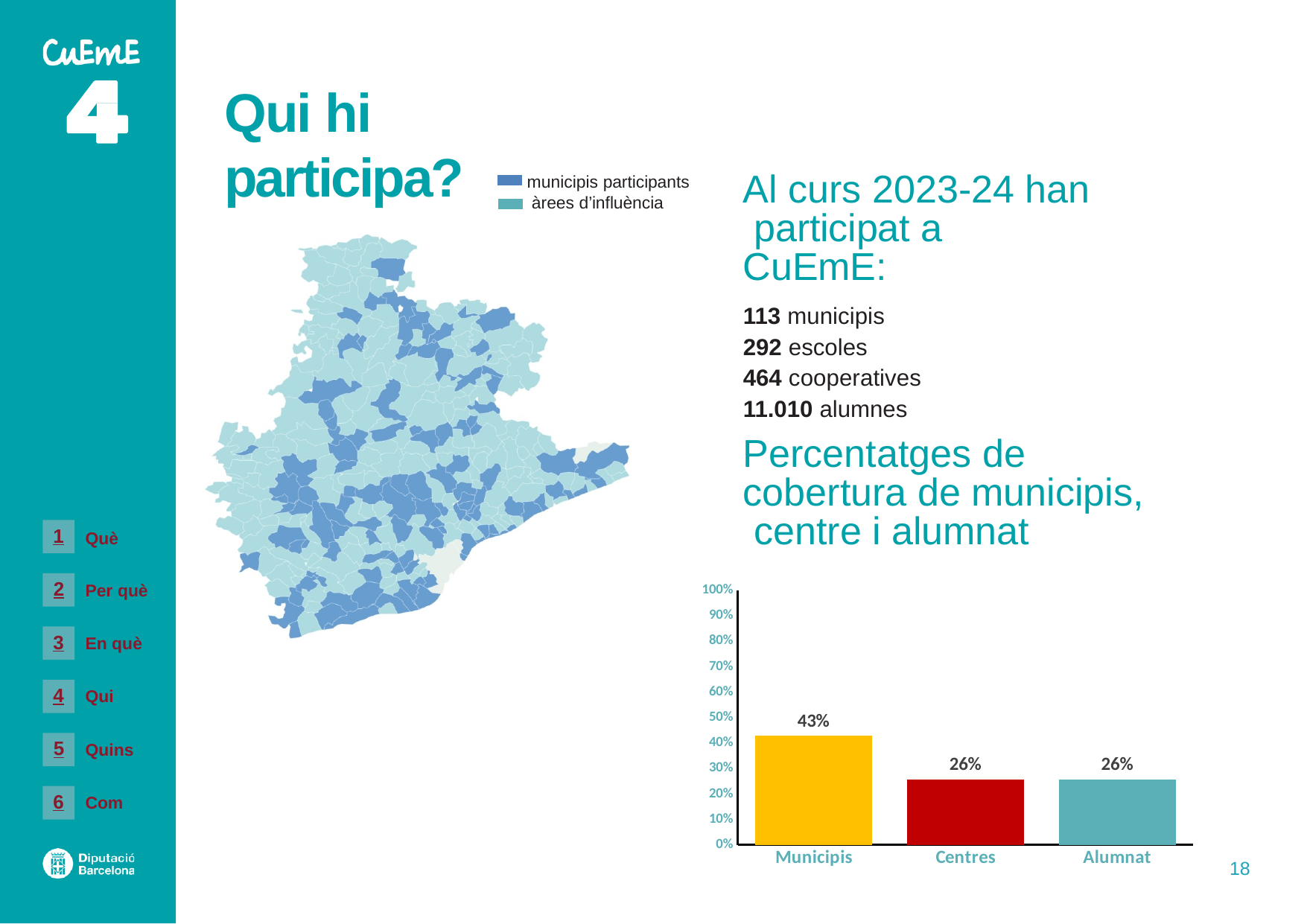
What is the value for Municipis in the bar chart? 43% Which category has the highest value in the bar chart? Municipis What is the value for Alumnat in the bar chart? 26% What is the value for Centres in the bar chart? 26% How many categories are shown in the bar chart? 3 What is the highest value shown on the vertical axis of the bar chart? 100% What is the difference between the values for Municipis and Centres in the bar chart? 17% What kind of chart is shown at the bottom right of the slide? bar chart Is the value for Centres in the bar chart greater or less than 30%? less What colour is the Municipis bar in the bar chart? yellow Which is larger in the bar chart, the value for Municipis or the value for Alumnat? Municipis Is the value for Municipis in the bar chart greater or less than 40%? greater